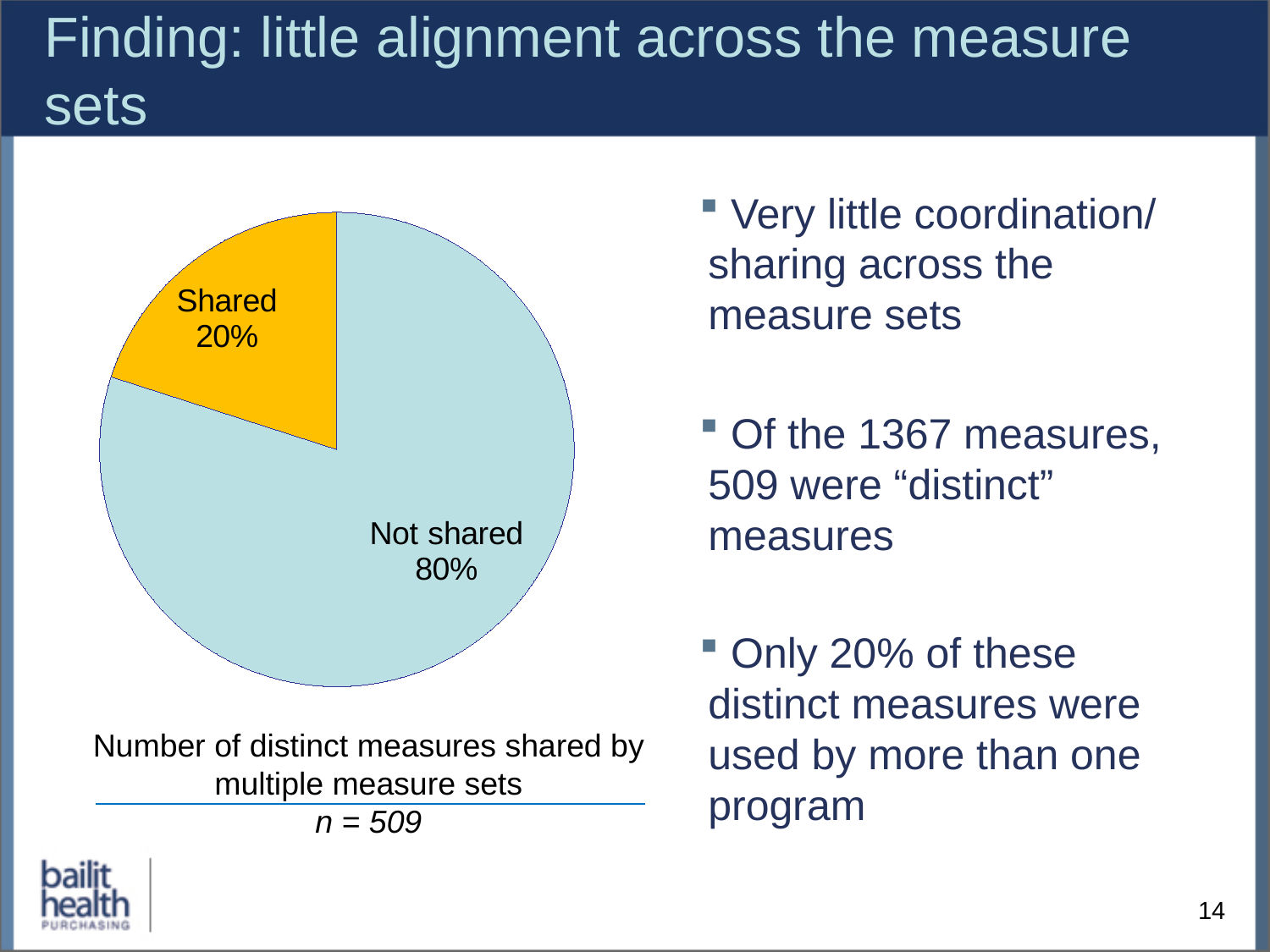
What colour is the "Shared" slice of the pie? yellow What kind of chart is shown on the slide? pie chart Which slice of the pie is the largest? Not shared What is the sample size (n) stated below the pie chart? 509 Which is larger, the "Shared" slice or the "Not shared" slice? Not shared Which slice of the pie is the smallest? Shared What is the difference in percentage points between the "Not shared" and "Shared" slices? 60 How many slices does the pie chart have? 2 What share of the pie is labelled "Not shared"? 80% What share of the pie is labelled "Shared"? 20%